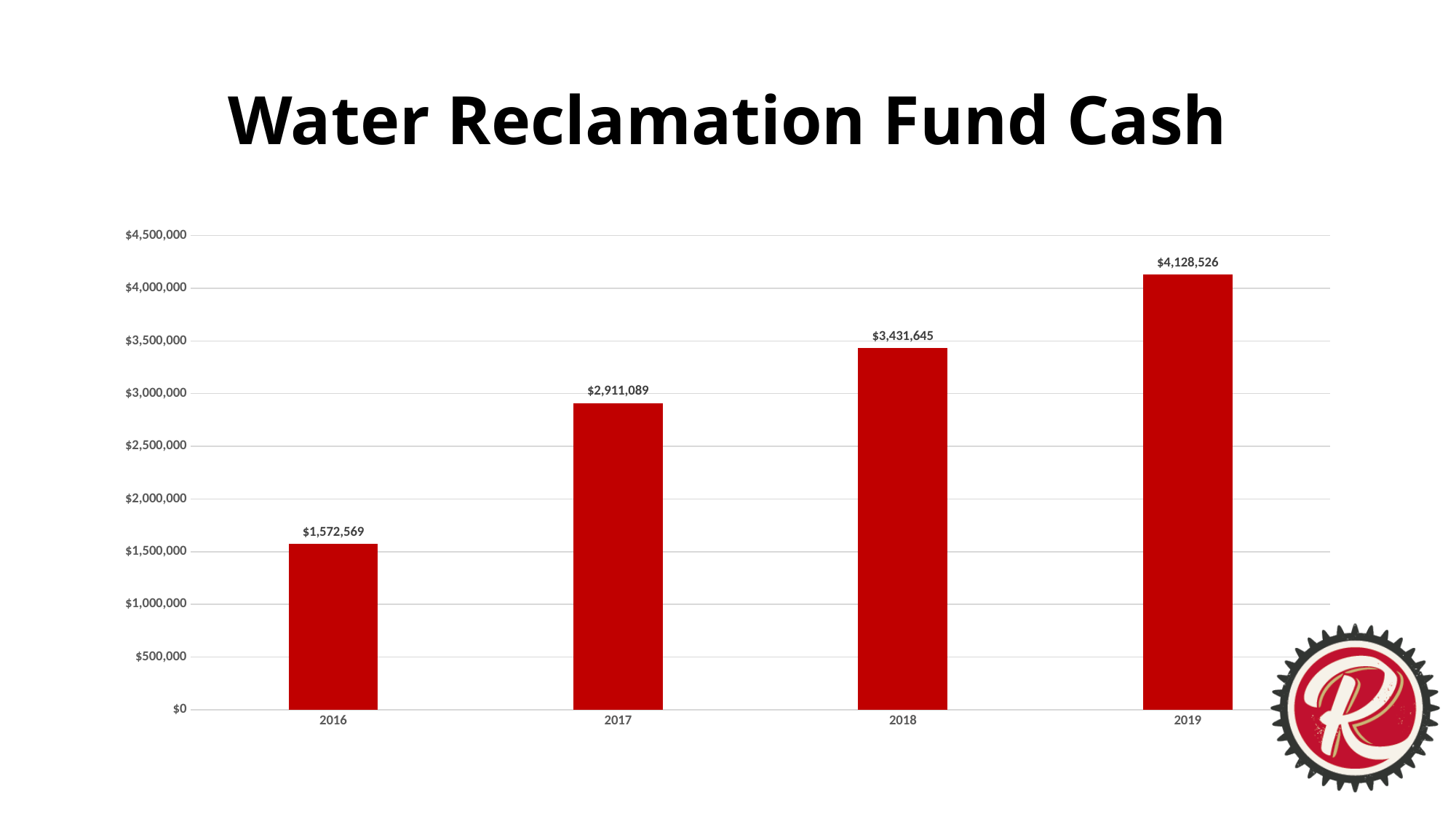
What is the Water Reclamation Fund cash value for 2016? $1,572,569 What is the Water Reclamation Fund cash value for 2018? $3,431,645 What is the difference between the 2018 and 2017 Water Reclamation Fund cash values? $520,556 Which year has the lowest Water Reclamation Fund cash value? 2016 What is the difference between the 2019 and 2016 Water Reclamation Fund cash values? $2,555,957 Is the Water Reclamation Fund cash value for 2019 greater or less than $4,000,000? greater What kind of chart is shown on the slide? Bar chart Which year has a larger Water Reclamation Fund cash value, 2017 or 2018? 2018 What is the Water Reclamation Fund cash value for 2019? $4,128,526 What is the Water Reclamation Fund cash value for 2017? $2,911,089 Which year has the highest Water Reclamation Fund cash value? 2019 How many years are shown on the chart? 4